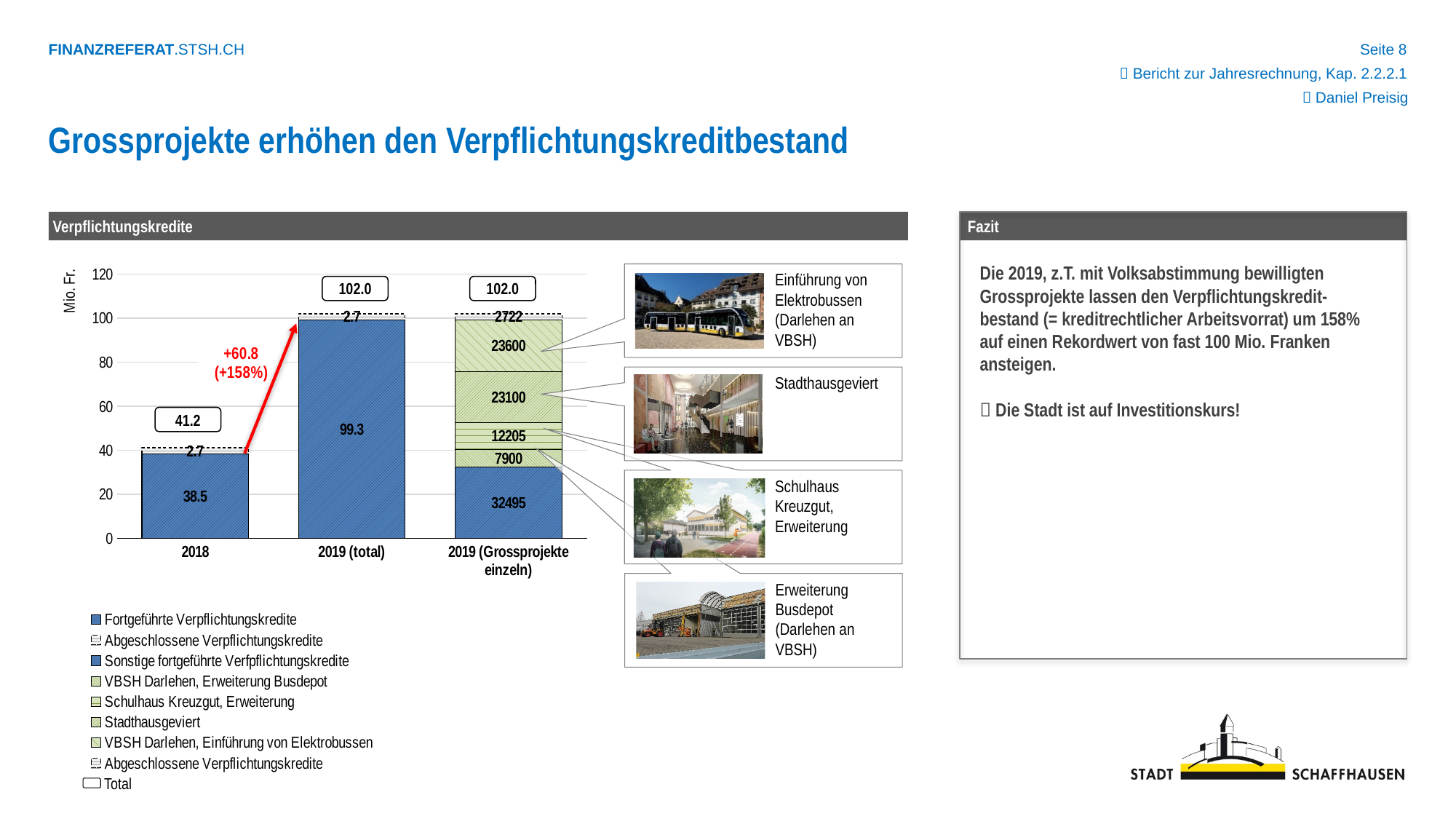
By how much does the total of '2019 (total)' exceed the total of 2018? 60.8 What is the total value shown above the '2019 (total)' bar? 102.0 How many bars are plotted on the x axis? 3 What kind of chart is shown under the heading 'Verpflichtungskredite'? Stacked bar chart What is the value of the 'Fortgeführte Verpflichtungskredite' segment in the 2018 bar? 38.5 What is the total value shown above the 2018 bar? 41.2 What is the value of the large blue segment in the '2019 (total)' bar? 99.3 Which bar has the lowest total value? 2018 What is the value of the Stadthausgeviert segment in the '2019 (Grossprojekte einzeln)' bar? 23100 What is the value of the segment linked to 'Einführung von Elektrobussen' in the '2019 (Grossprojekte einzeln)' bar? 23600 What is the value of the 'Abgeschlossene Verpflichtungskredite' segment in the 2018 bar? 2.7 What percentage increase is annotated on the red arrow between 2018 and 2019 (total)? +158%